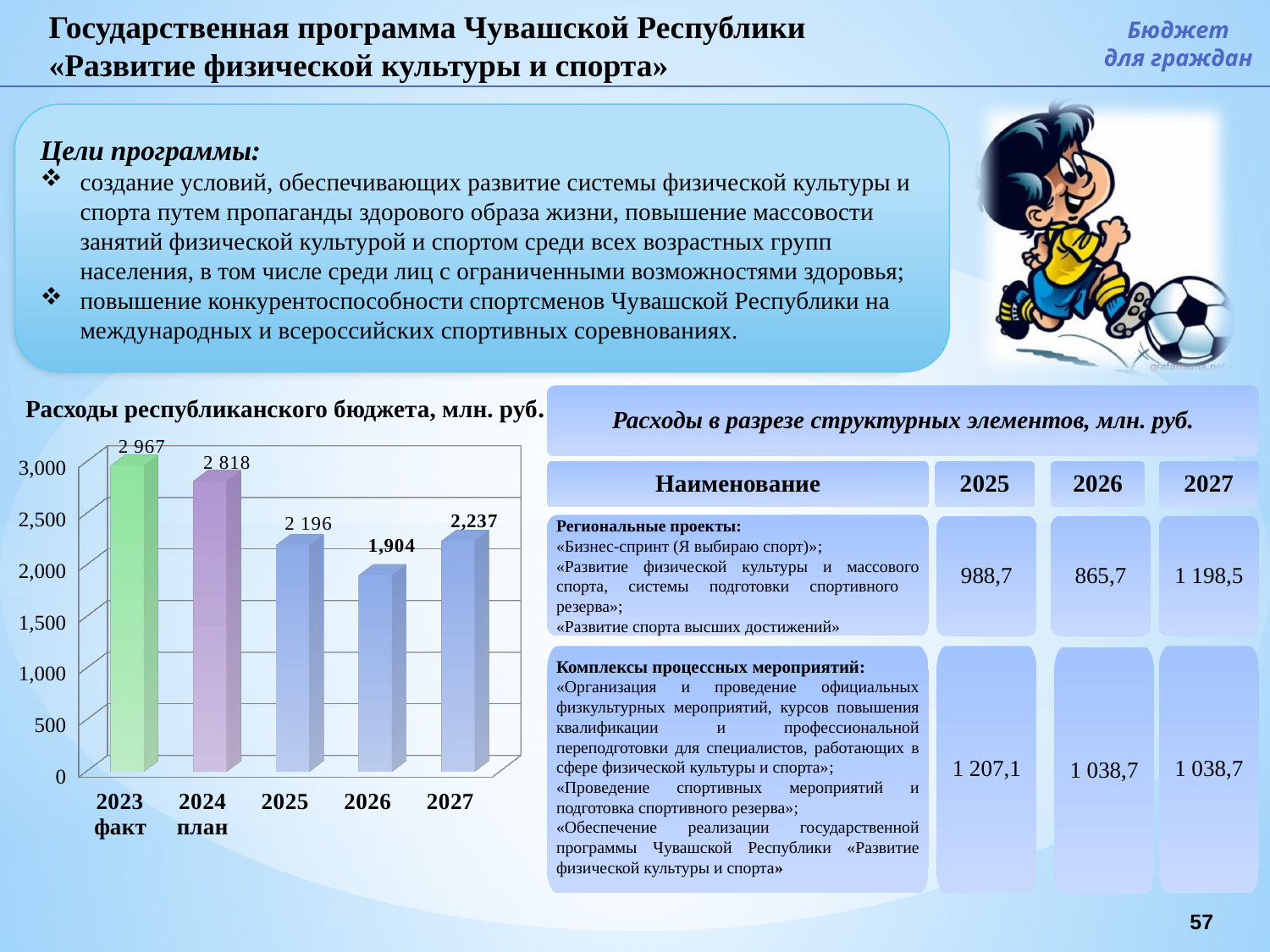
What is the value for 2025 in the chart? 2 196 What type of chart is shown on the slide? bar chart What is the value for 2023 факт in the chart? 2 967 What is the value for 2027 in the chart? 2,237 What is the value for 2024 план in the chart? 2 818 Which year has the highest value in the chart? 2023 факт Which is larger, the value for 2025 or the value for 2027? 2027 How many bars (categories) does the chart show? 5 Which year has the lowest value in the chart? 2026 What is the difference between the values for 2023 факт and 2024 план? 149 What is the value for 2026 in the chart? 1,904 What is the title of the chart on the slide? Расходы республиканского бюджета, млн. руб.